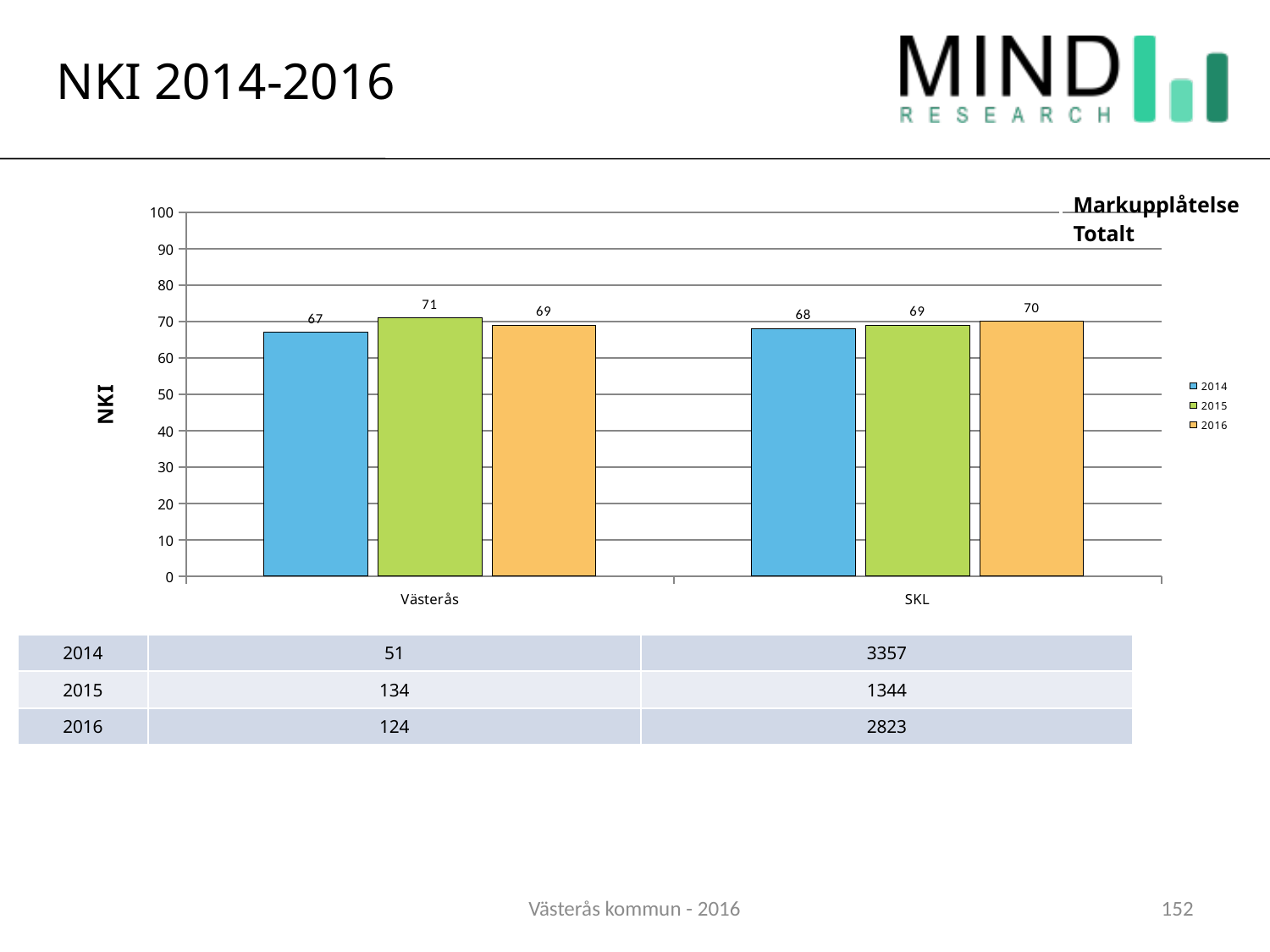
What is the difference between the 2015 and 2014 NKI values for Västerås? 4 Which year has the lowest NKI value for SKL? 2014 Which year has the highest NKI value for Västerås? 2015 What kind of chart is shown on the slide? Bar chart What is the NKI value for SKL in 2014? 68 What is the NKI value for SKL in 2016? 70 How many series does the legend list? 3 Which is larger, the 2016 NKI value for Västerås or for SKL? SKL What is the label of the y axis? NKI What is the NKI value for Västerås in 2015? 71 How many categories are shown on the x axis? 2 What is the NKI value for Västerås in 2014? 67